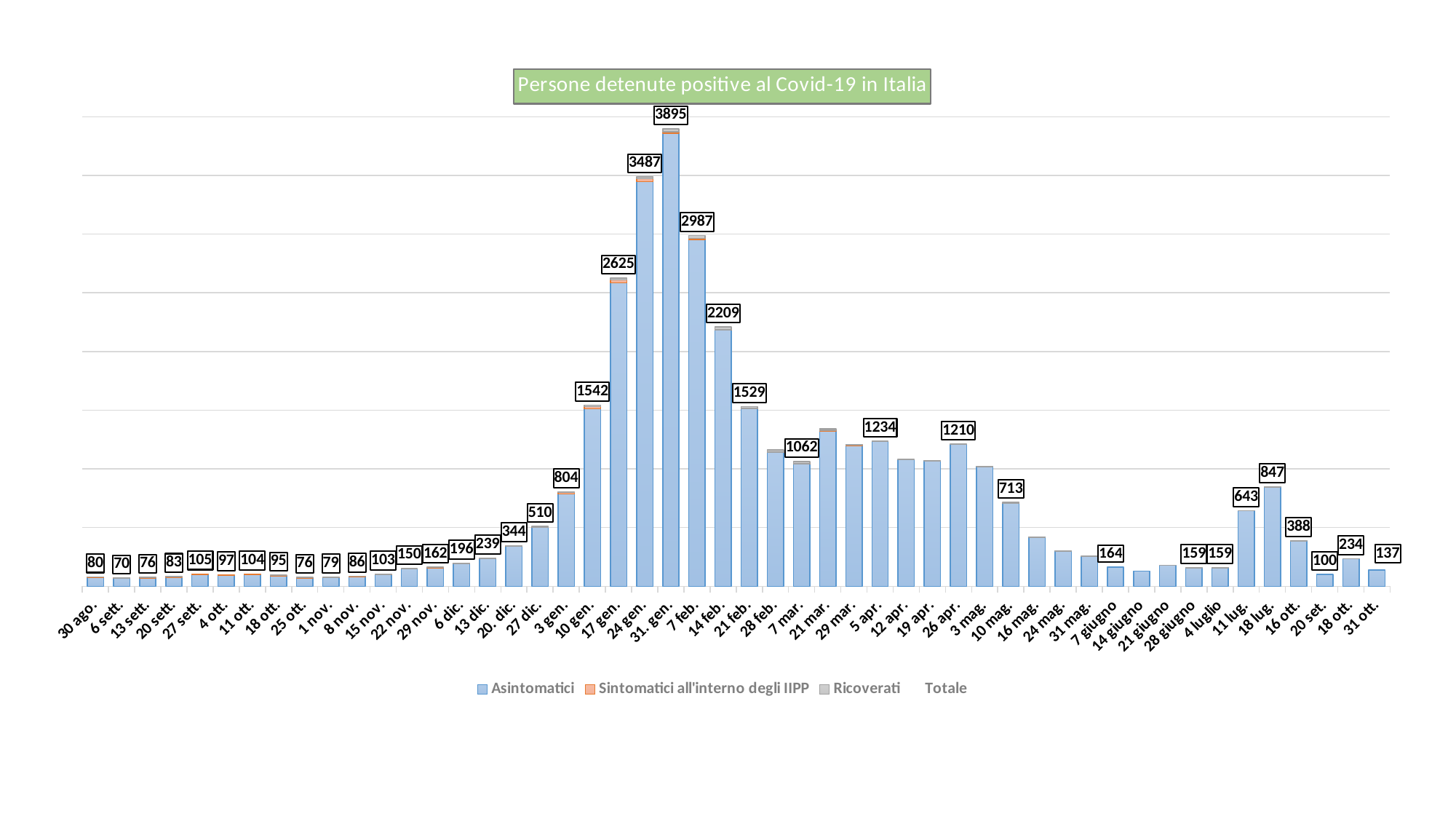
What is the total value shown for 17 gen.? 2625 What kind of chart is this? Stacked bar chart What is the total value shown for 18 lug.? 847 Do the totals rise or fall from 31. gen. to 21 feb.? Fall What is the total value shown for 31. gen.? 3895 What is the difference between the totals for 31. gen. and 24 gen.? 408 Which date has the lowest total? 6 sett. How many dates are shown on the x axis? 50 Which has a larger total, 7 feb. or 17 gen.? 7 feb. What is the title of the chart? Persone detenute positive al Covid-19 in Italia How many series does the legend list? 4 Which date has the highest total? 31. gen.